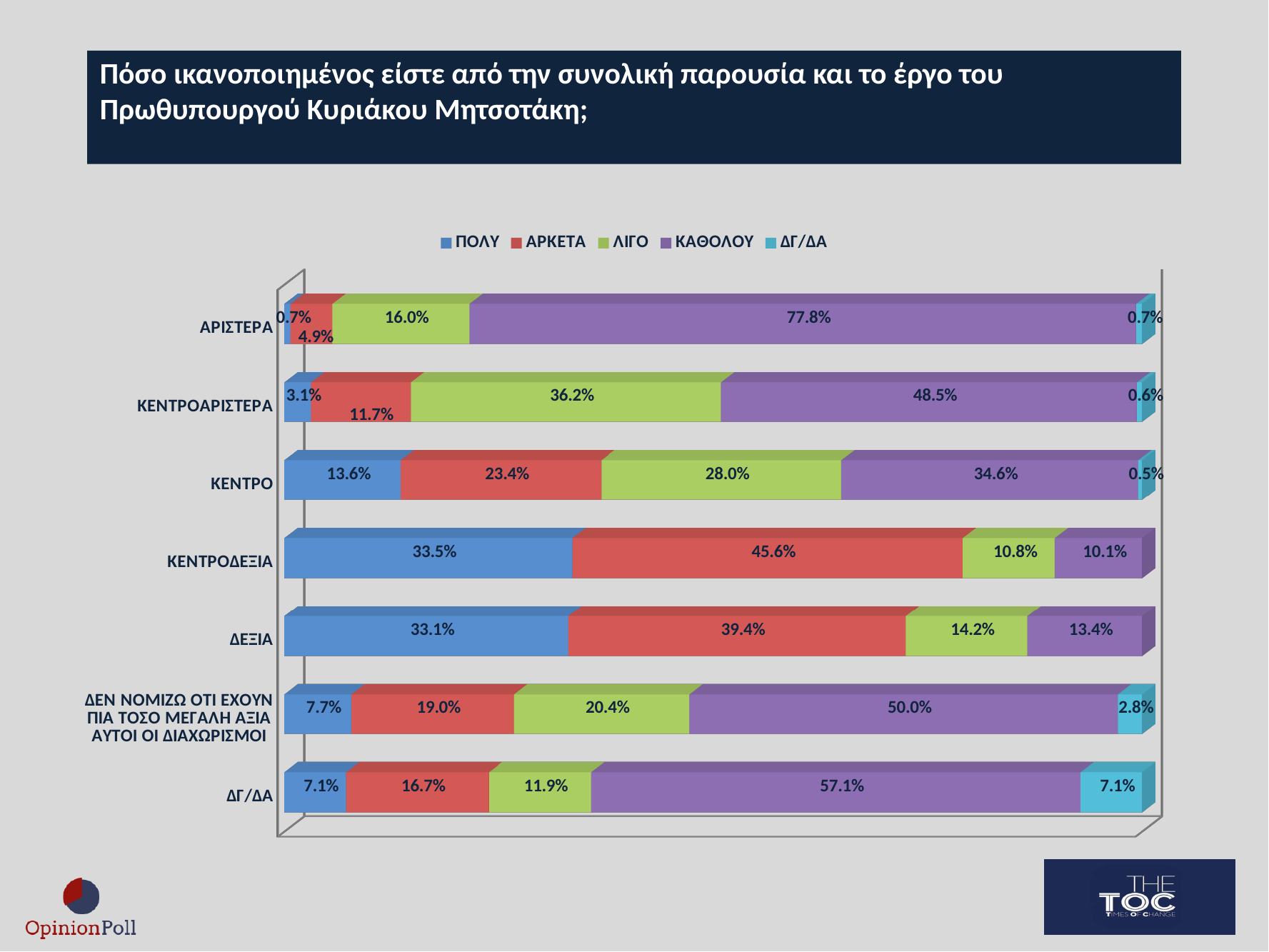
What is the ΔΓ/ΔΑ value for the ΔΓ/ΔΑ category? 7.1% What is the ΑΡΚΕΤΑ value for ΚΕΝΤΡΟΔΕΞΙΑ? 45.6% How many categories are shown on the chart? 7 Which category has the highest ΚΑΘΟΛΟΥ value? ΑΡΙΣΤΕΡΑ Which category has the lowest ΠΟΛΥ value? ΑΡΙΣΤΕΡΑ What percentage of ΑΡΙΣΤΕΡΑ respondents answered ΚΑΘΟΛΟΥ? 77.8% What is the ΛΙΓΟ value for ΚΕΝΤΡΟΑΡΙΣΤΕΡΑ? 36.2% What kind of chart is shown on the slide? Stacked bar chart Which has a larger ΑΡΚΕΤΑ value, ΚΕΝΤΡΟΔΕΞΙΑ or ΔΕΞΙΑ? ΚΕΝΤΡΟΔΕΞΙΑ What is the difference between the ΚΑΘΟΛΟΥ and ΠΟΛΥ values for ΚΕΝΤΡΟ? 21.0 percentage points How many series does the legend list? 5 Which colour represents ΚΑΘΟΛΟΥ in the legend? Purple